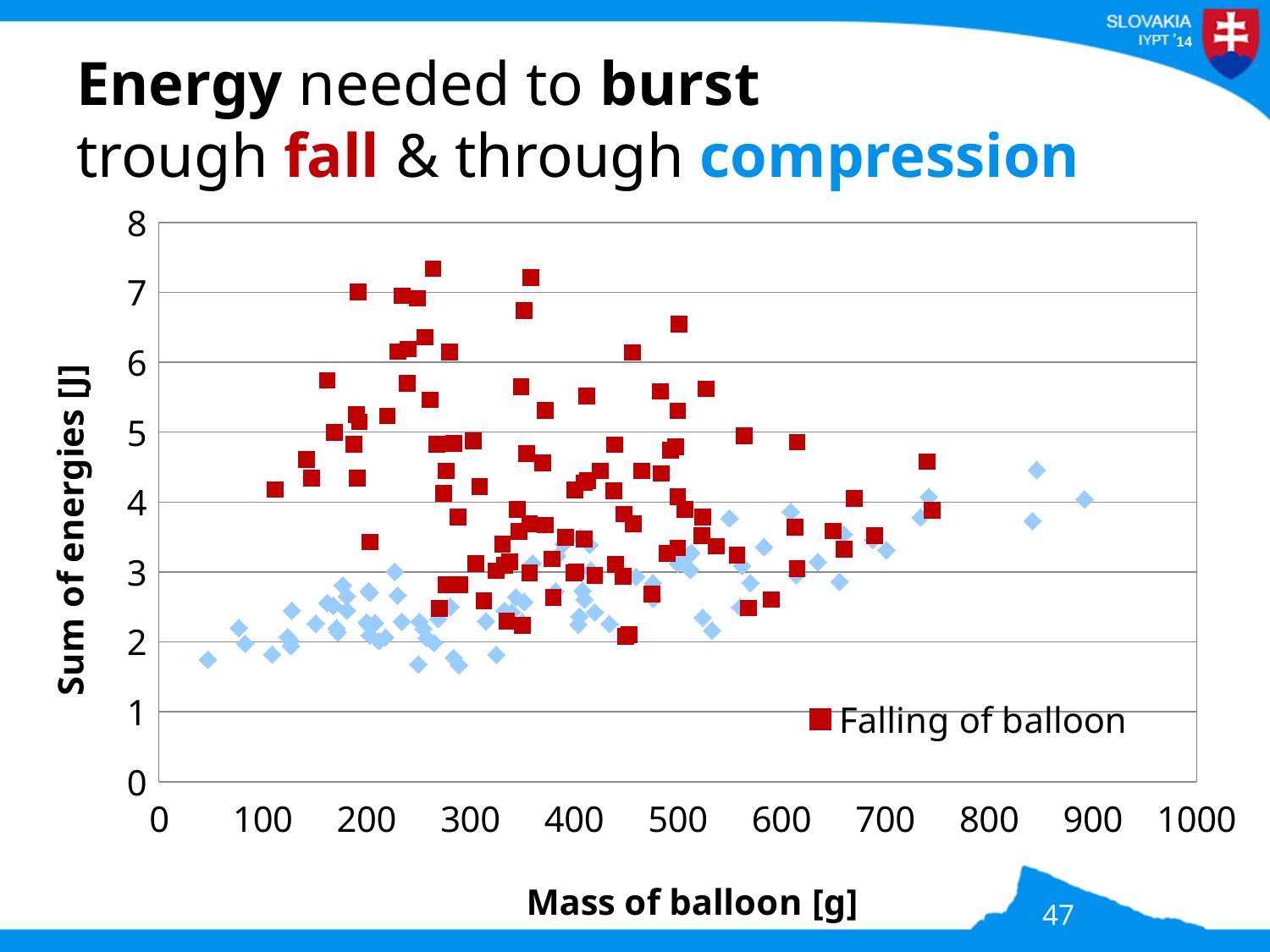
Is the highest light-blue diamond point greater or less than 5 on the energy axis? less Is the lowest light-blue diamond point greater or less than 2 on the energy axis? less Is the red 'Falling of balloon' point with the largest mass greater or less than 800 g on the mass axis? less Which series reaches higher energy values, the red squares or the light-blue diamonds? red squares (Falling of balloon) Do the light-blue diamond points generally rise or fall as the mass of the balloon increases? rise What kind of chart is shown on the slide? scatter chart How many series does the chart's legend list? 1 What is the name of the series shown in the chart's legend? Falling of balloon What is the title of the vertical axis of the chart? Sum of energies [J]